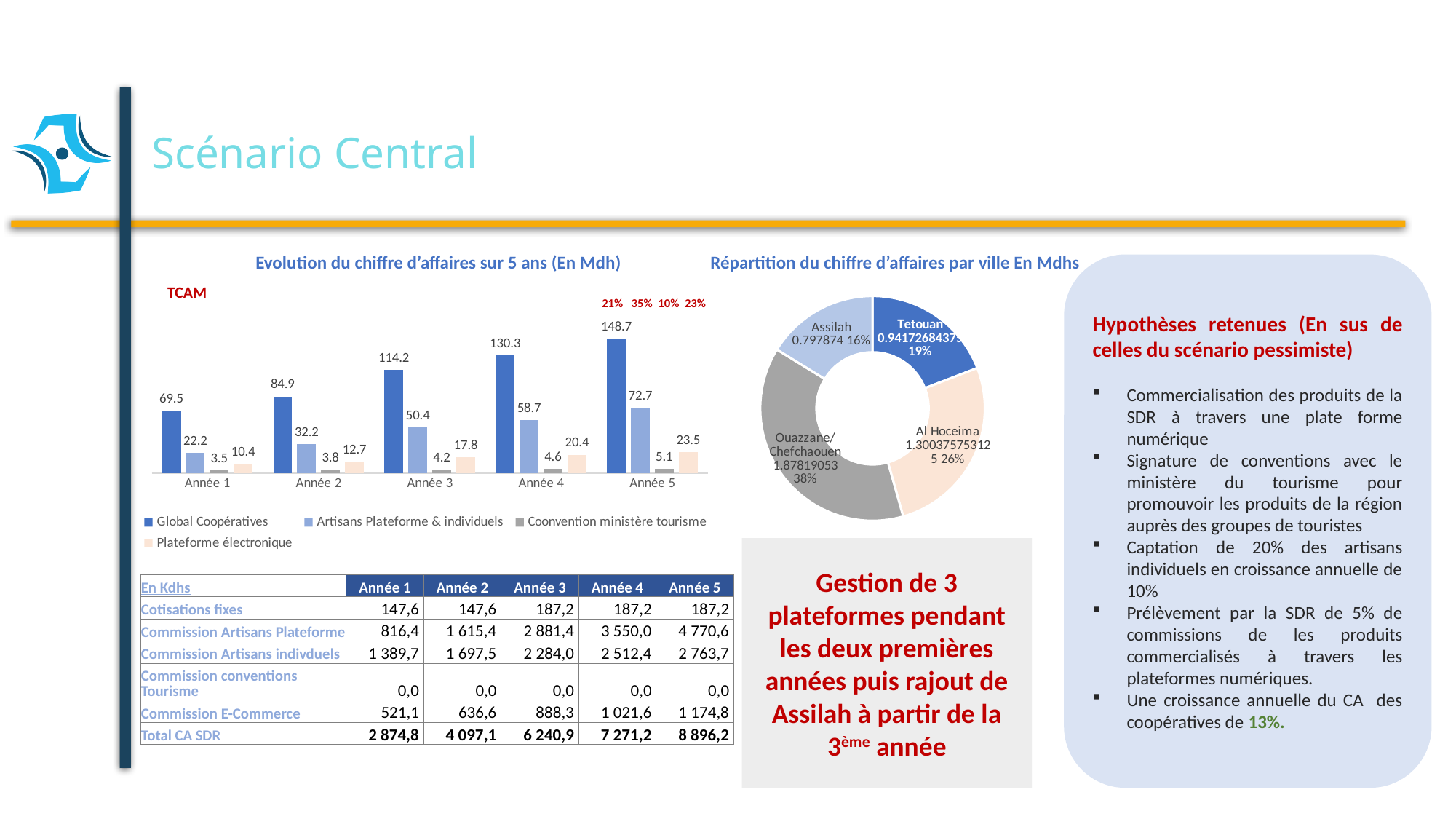
In the bar chart 'Evolution du chiffre d'affaires sur 5 ans (En Mdh)', what is the value for Plateforme électronique in Année 1? 10.4 In the doughnut chart 'Répartition du chiffre d'affaires par ville En Mdhs', what share does Ouazzane/Chefchaouen have? 38% In the bar chart 'Evolution du chiffre d'affaires sur 5 ans (En Mdh)', in which year is the Coonvention ministère tourisme value lowest? Année 1 In the bar chart 'Evolution du chiffre d'affaires sur 5 ans (En Mdh)', what is the value for Global Coopératives in Année 5? 148.7 In the doughnut chart 'Répartition du chiffre d'affaires par ville En Mdhs', which city has the smallest share? Assilah In the bar chart 'Evolution du chiffre d'affaires sur 5 ans (En Mdh)', what is the value for Artisans Plateforme & individuels in Année 3? 50.4 In the bar chart 'Evolution du chiffre d'affaires sur 5 ans (En Mdh)', how many years are shown on the x axis? 5 In the bar chart 'Evolution du chiffre d'affaires sur 5 ans (En Mdh)', how many series does the legend list? 4 In the bar chart 'Evolution du chiffre d'affaires sur 5 ans (En Mdh)', which is larger in Année 2: Artisans Plateforme & individuels or Plateforme électronique? Artisans Plateforme & individuels In the bar chart 'Evolution du chiffre d'affaires sur 5 ans (En Mdh)', in which year is the Global Coopératives value highest? Année 5 In the bar chart 'Evolution du chiffre d'affaires sur 5 ans (En Mdh)', do the Global Coopératives values rise or fall from Année 1 to Année 5? rise In the bar chart 'Evolution du chiffre d'affaires sur 5 ans (En Mdh)', what is the difference between the Global Coopératives values in Année 5 and Année 4? 18.4